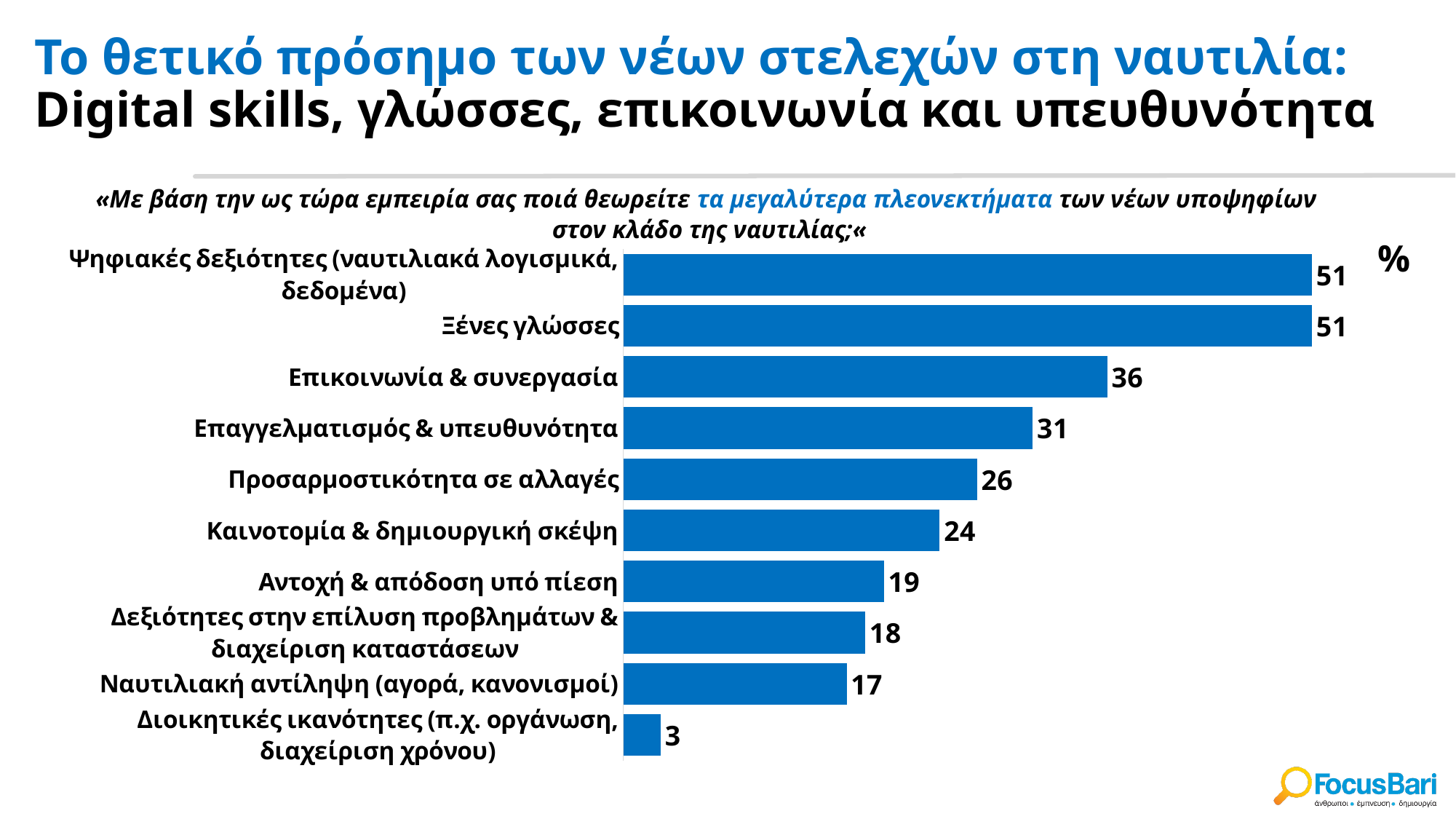
What is the difference between the values for Ξένες γλώσσες and Καινοτομία & δημιουργική σκέψη? 27 What is the value for Ναυτιλιακή αντίληψη (αγορά, κανονισμοί)? 17 What is the difference between the values for Επικοινωνία & συνεργασία and Επαγγελματισμός & υπευθυνότητα? 5 Which category has the lowest value? Διοικητικές ικανότητες (π.χ. οργάνωση, διαχείριση χρόνου) What is the value for Προσαρμοστικότητα σε αλλαγές? 26 How many categories are shown in the chart? 10 What is the value for Ξένες γλώσσες? 51 What is the value for Δεξιότητες στην επίλυση προβλημάτων & διαχείριση καταστάσεων? 18 What is the value for Επικοινωνία & συνεργασία? 36 Which is larger: the value for Αντοχή & απόδοση υπό πίεση or the value for Προσαρμοστικότητα σε αλλαγές? Προσαρμοστικότητα σε αλλαγές What kind of chart is shown on the slide? Bar chart What unit symbol is shown next to the chart? %